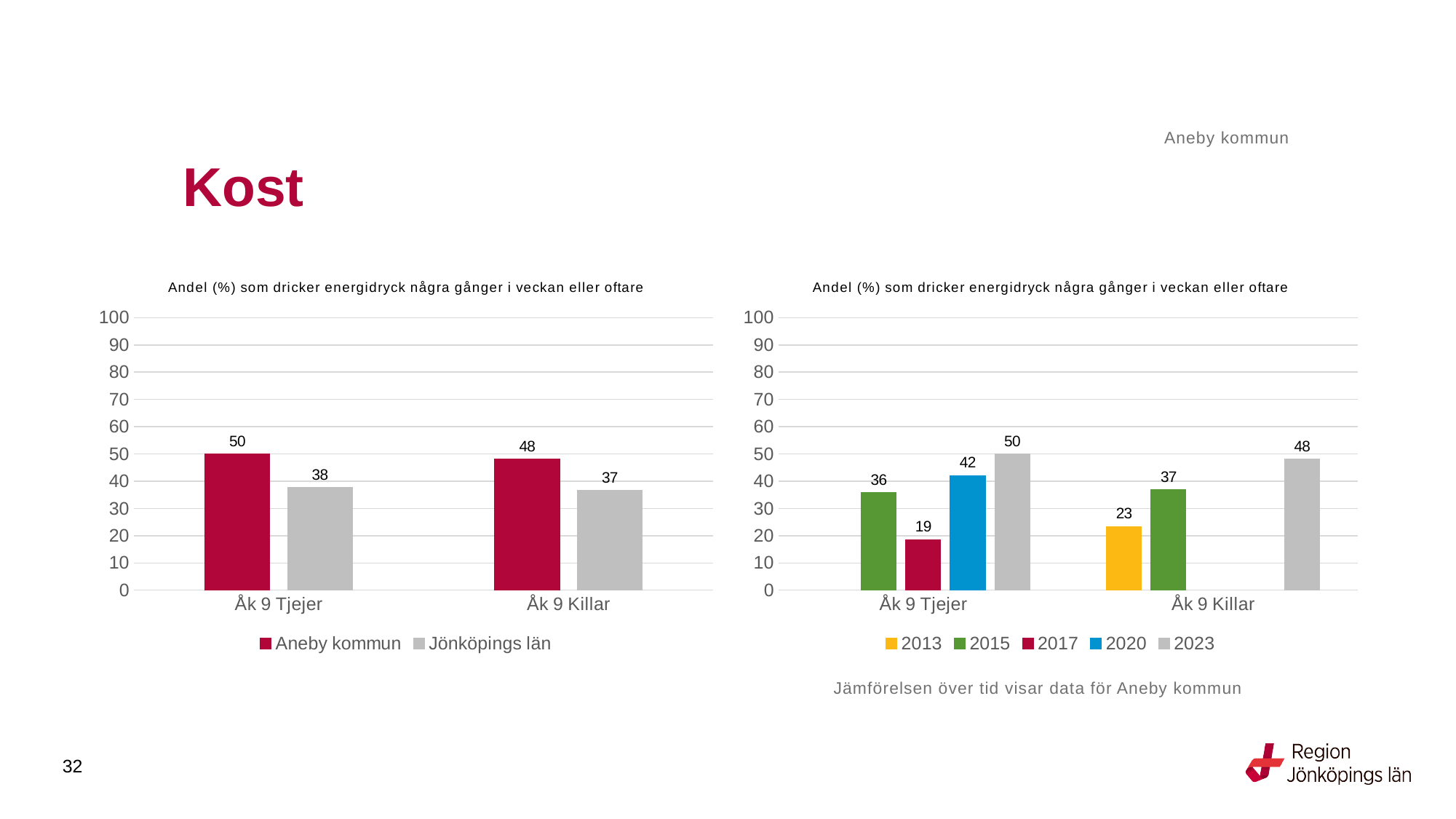
In the left chart, how many series does the legend list? 2 In the left chart, which is larger for Åk 9 Killar: Aneby kommun or Jönköpings län? Aneby kommun In the right chart, how many series does the legend list? 5 In the left chart, what is the difference between Aneby kommun and Jönköpings län for Åk 9 Tjejer? 12 In the right chart, which year has the highest value for Åk 9 Tjejer? 2023 In the left chart, what is the value for Jönköpings län for Åk 9 Killar? 37 What kind of chart is the left chart? Bar chart In the right chart, which year has the lowest value for Åk 9 Killar? 2013 In the left chart, what is the value for Aneby kommun for Åk 9 Tjejer? 50 In the right chart, what is the difference between 2023 and 2015 for Åk 9 Killar? 11 In the right chart, what is the value for 2017 for Åk 9 Tjejer? 19 In the right chart, what is the value for 2013 for Åk 9 Killar? 23